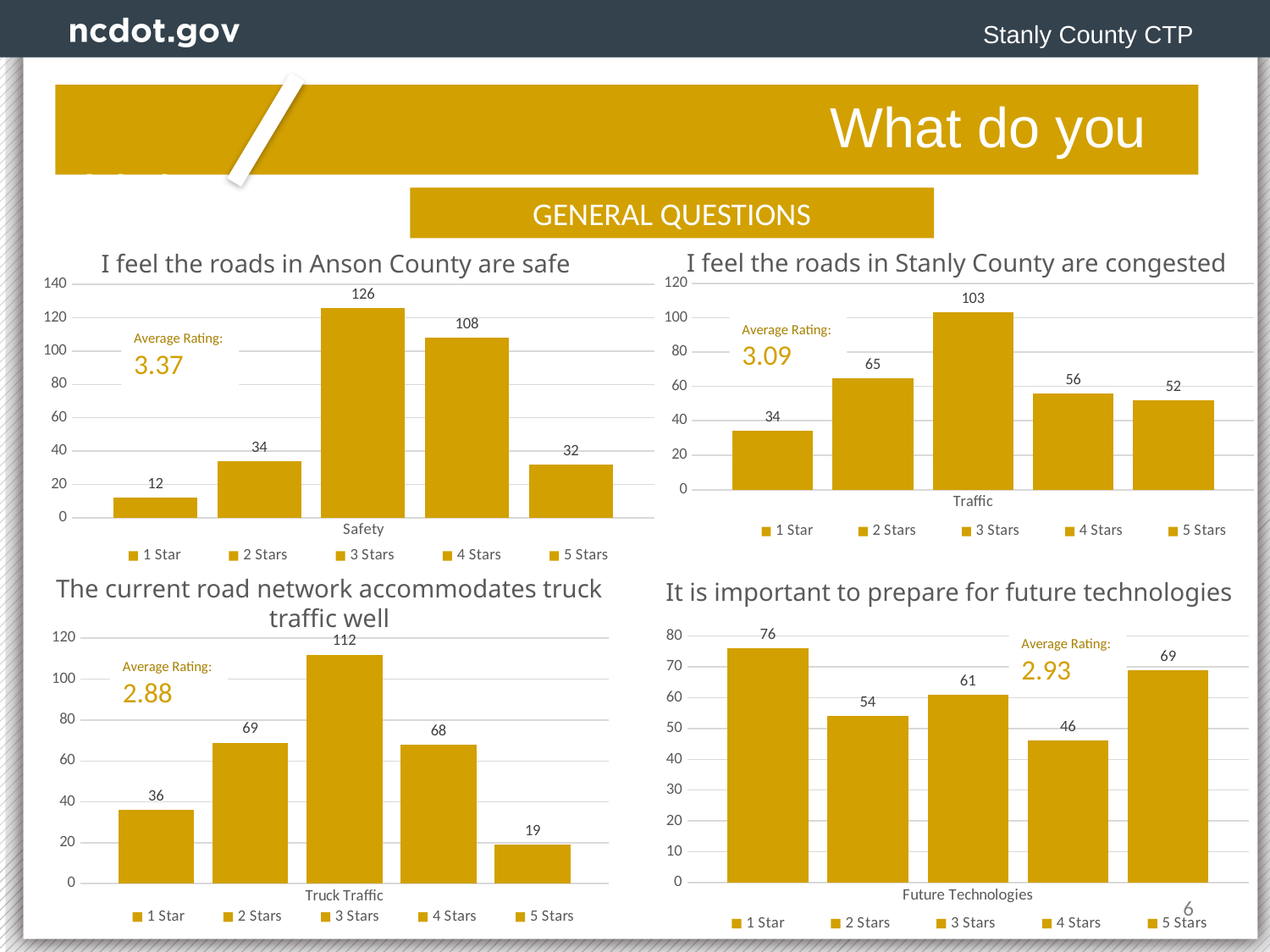
In the chart titled "The current road network accommodates truck traffic well", which is larger, the value for 2 Stars or the value for 4 Stars? 2 Stars In the chart titled "I feel the roads in Anson County are safe", what is the difference between the 3 Stars and 4 Stars values? 18 In the chart titled "I feel the roads in Stanly County are congested", what is the value for 2 Stars? 65 What kind of chart is the chart titled "The current road network accommodates truck traffic well"? Bar chart In the chart titled "It is important to prepare for future technologies", which rating has the lowest value? 4 Stars How many series does the legend list in the chart titled "It is important to prepare for future technologies"? 5 In the chart titled "The current road network accommodates truck traffic well", what is the value for 5 Stars? 19 In the chart titled "I feel the roads in Anson County are safe", which rating has the lowest value? 1 Star In the chart titled "I feel the roads in Anson County are safe", what is the value for 3 Stars? 126 In the chart titled "I feel the roads in Stanly County are congested", which rating has the highest value? 3 Stars In the chart titled "I feel the roads in Stanly County are congested", what is the average rating shown? 3.09 In the chart titled "It is important to prepare for future technologies", what is the value for 1 Star? 76